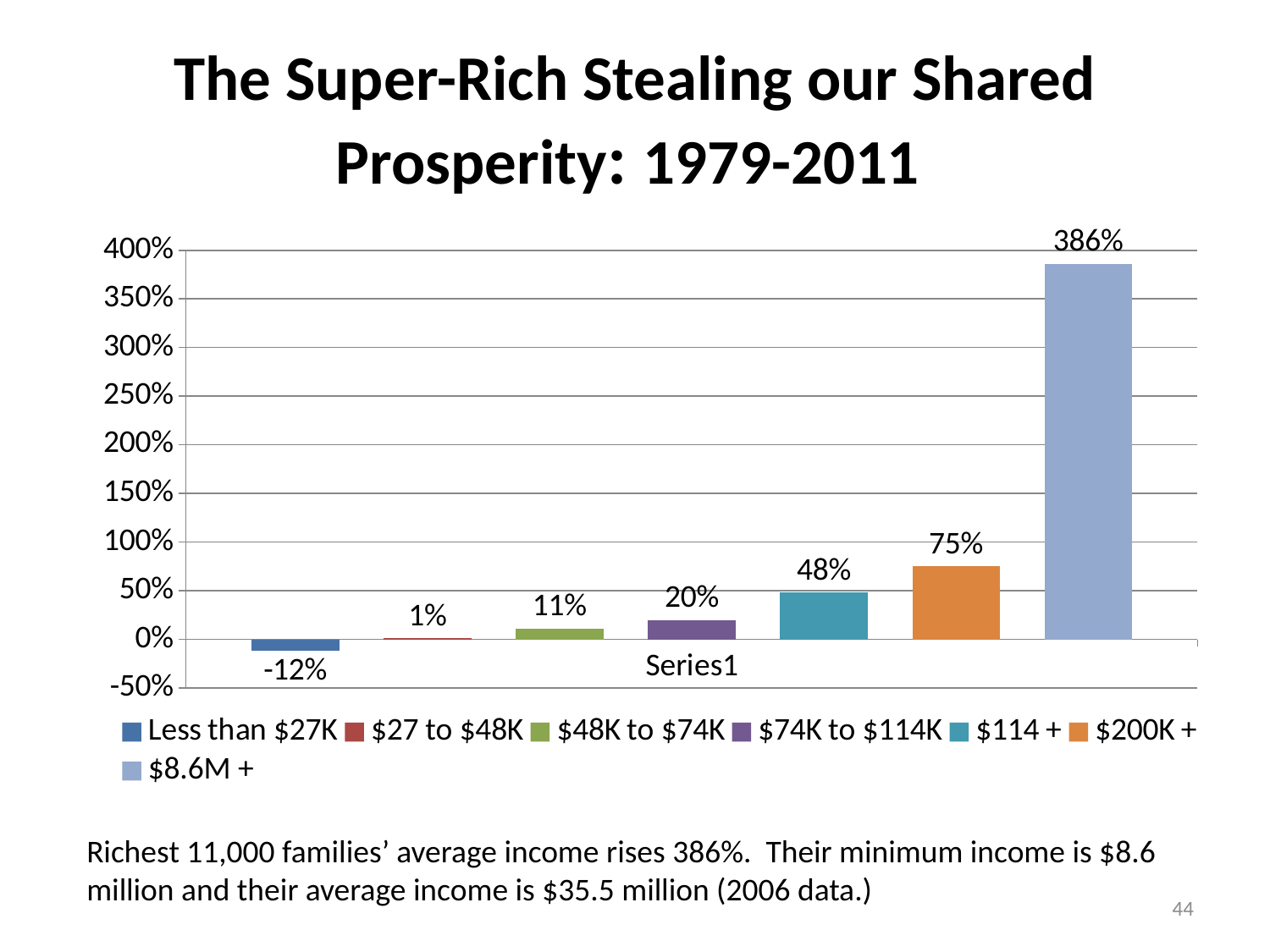
What is the value shown for the $200K + group? 75% What is the value shown for the Less than $27K group? -12% What is the difference between the values for $8.6M + and $200K +? 311% What is the difference between the values for $114 + and $48K to $74K? 37% What is the value shown for the $74K to $114K group? 20% Which income group has the highest value on the chart? $8.6M + What is the value shown for the $8.6M + group? 386% What kind of chart is shown on the slide? Bar chart What is the title of the slide containing the chart? The Super-Rich Stealing our Shared Prosperity: 1979-2011 Which income group has the lowest value on the chart? Less than $27K How many income groups does the legend list? 7 Which is larger, the value for $114 + or the value for $74K to $114K? $114 +